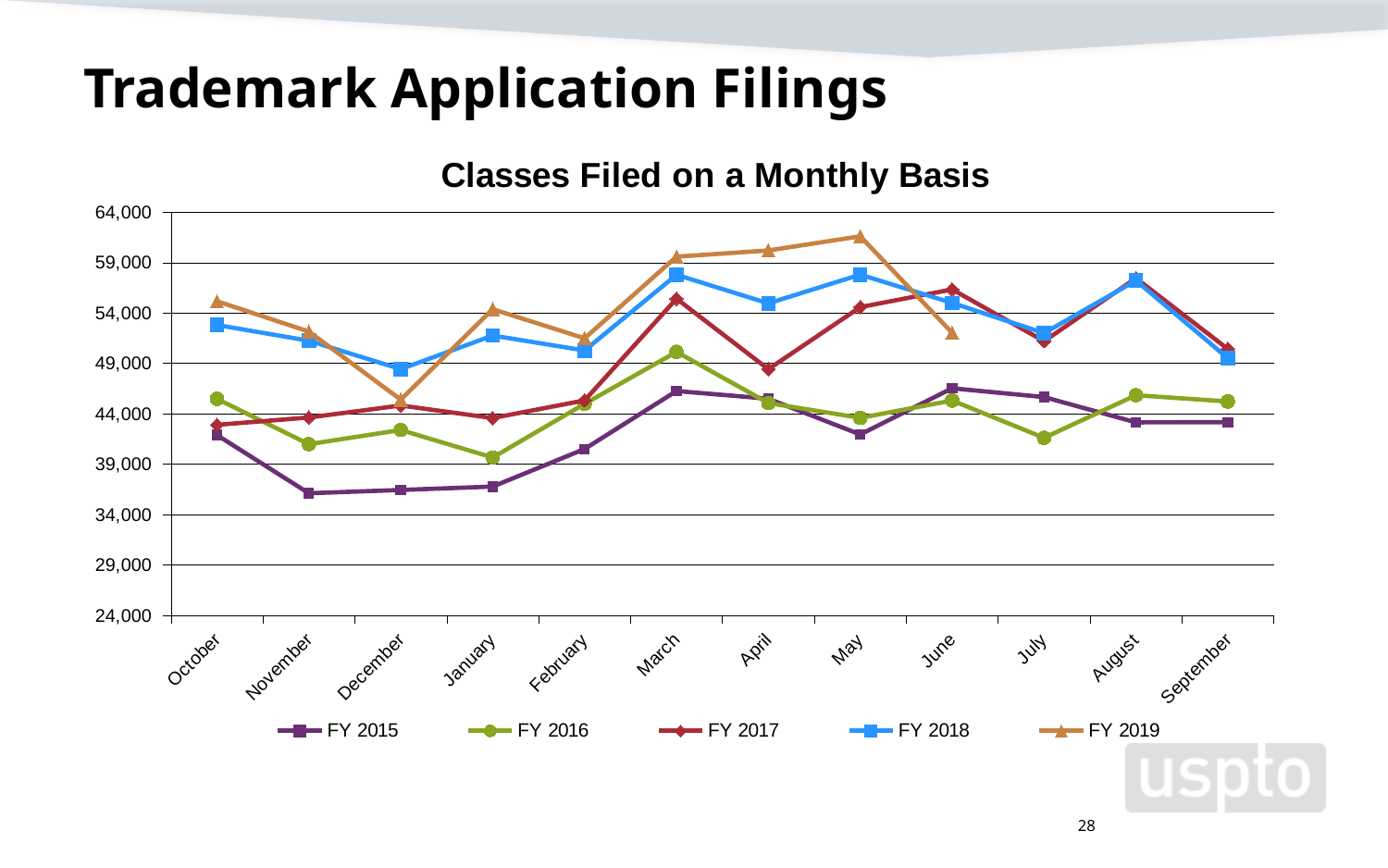
What type of chart is shown on the slide? Line chart In which month does the FY 2019 series reach its highest value? May Is the value for FY 2015 in November greater or less than 39,000? less In March, which is larger: FY 2019 or FY 2015? FY 2019 How many series does the legend list? 5 How many months are shown along the x axis? 12 What is the title of the chart? Classes Filed on a Monthly Basis Which series has the highest value in May? FY 2019 Is the value for FY 2018 in March greater or less than 54,000? greater In which month does the FY 2016 series reach its lowest value? January Is the value for FY 2019 in May greater or less than 59,000? greater Which series has data plotted only through June? FY 2019